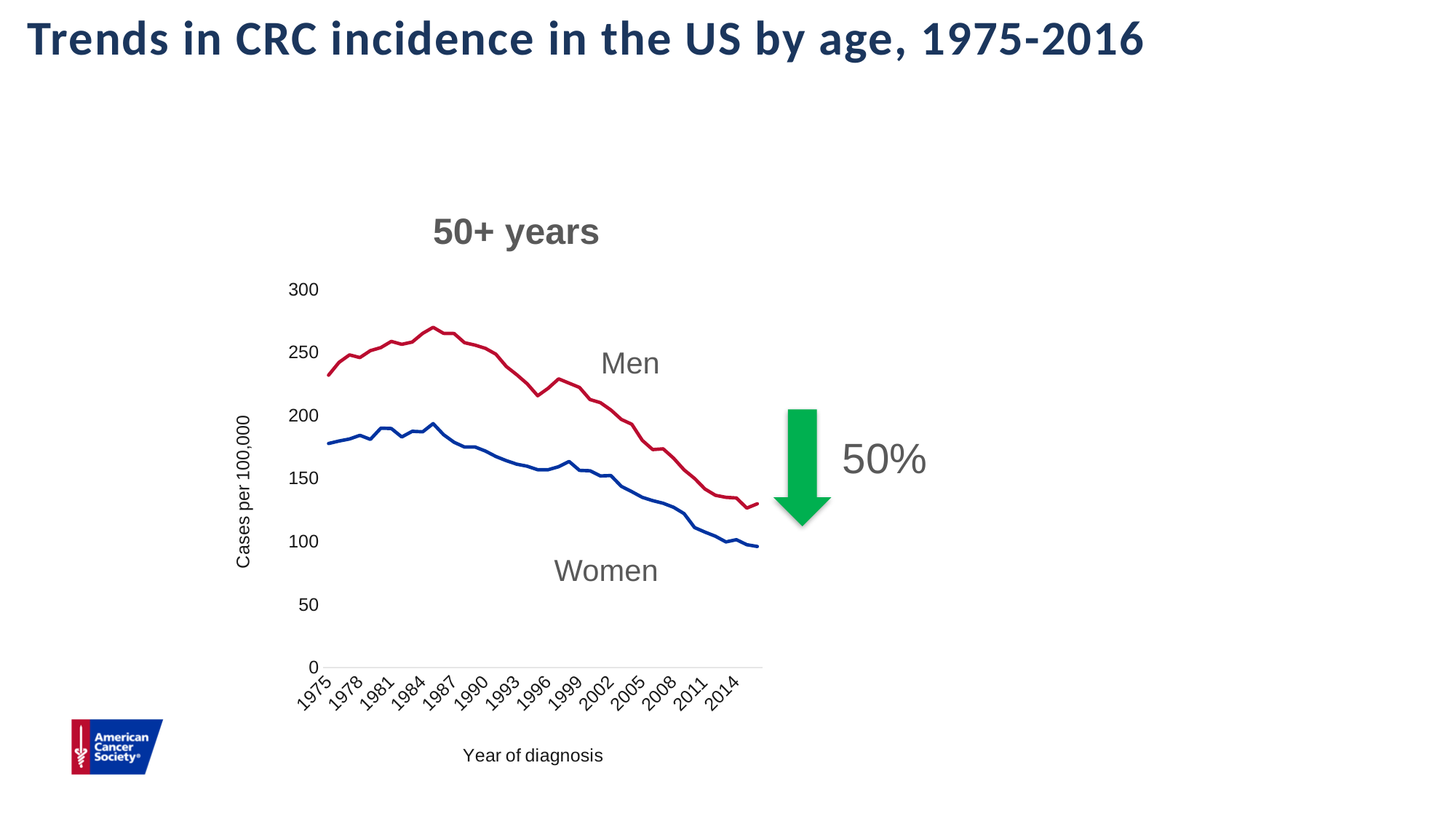
What is the label on the vertical axis of the chart? Cases per 100,000 Is the value for Men in 2014 greater or less than 150? less What is the title of the chart? 50+ years Is the value for Men in 1987 greater or less than 250? greater In 1975, which series has the higher value, Men or Women? Men Is the value for Men in 1975 greater or less than 200? greater Between 1990 and 2014, does the Men line rise or fall? fall In 2014, which series has the higher value, Men or Women? Men How many data series are plotted on the chart? 2 What kind of chart is shown on the slide? line chart Between 1990 and 2014, does the Women line rise or fall? fall